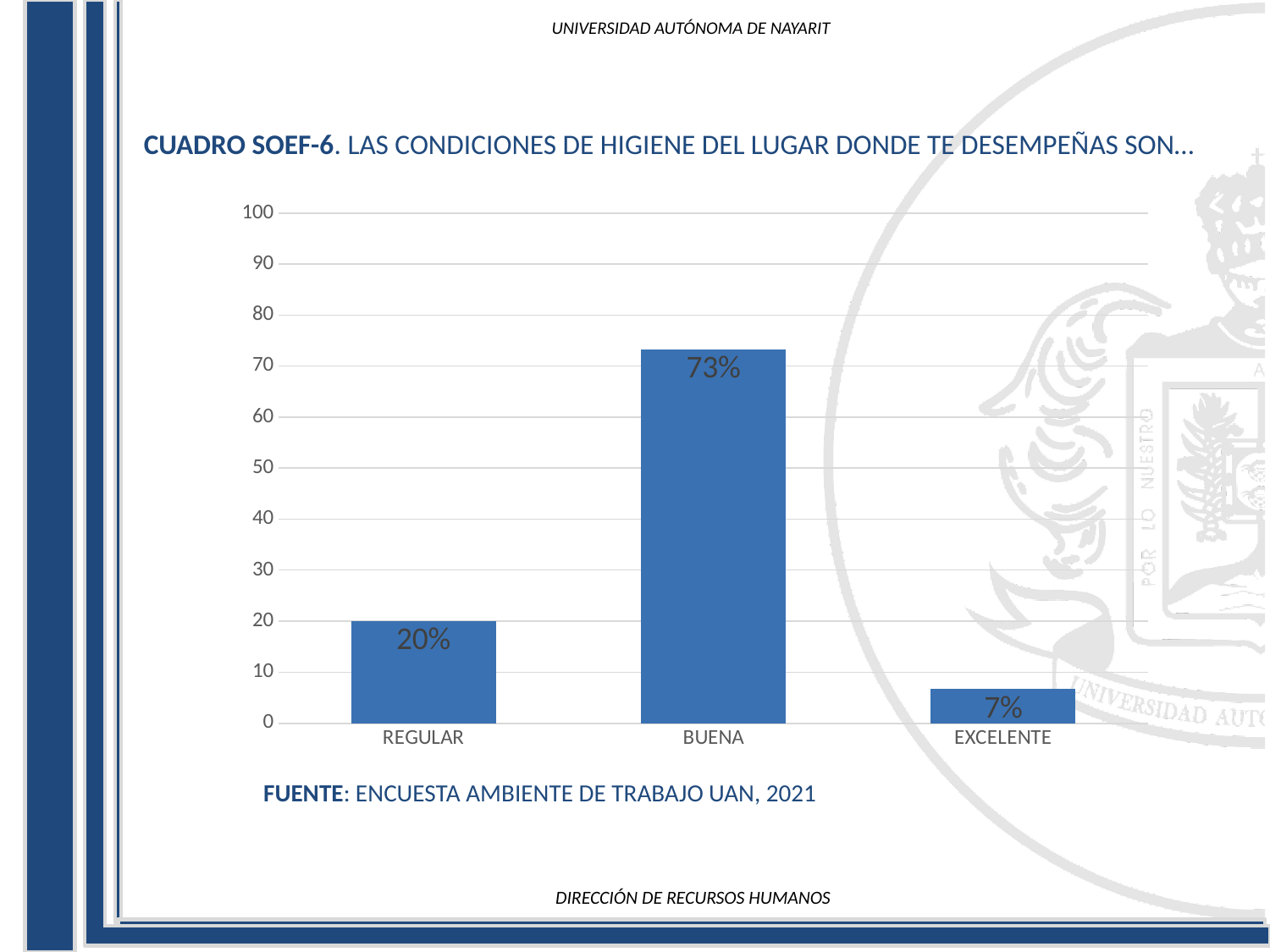
Which category has the highest value? BUENA How many categories are shown on the x axis? 3 What is the difference between the values for BUENA and REGULAR? 53% What is the difference between the values for REGULAR and EXCELENTE? 13% What is the value for EXCELENTE? 7% Is the value for BUENA greater or less than 50? greater Which is larger, the value for REGULAR or the value for EXCELENTE? REGULAR What is the value for REGULAR? 20% What source is cited below the chart? ENCUESTA AMBIENTE DE TRABAJO UAN, 2021 What is the value for BUENA? 73% Which category has the lowest value? EXCELENTE What kind of chart is shown on the slide? bar chart